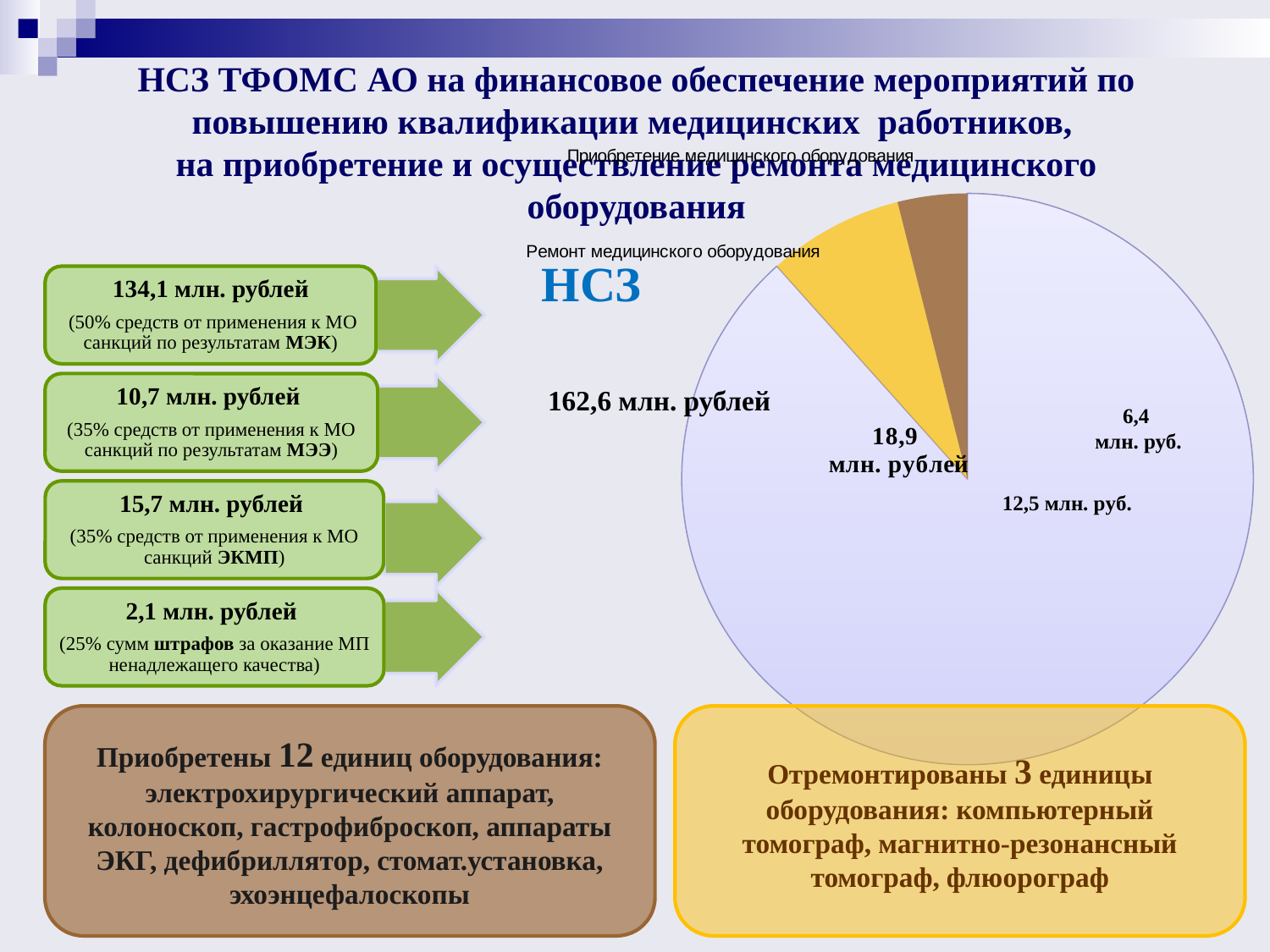
How many slices does the pie chart have? 3 What are the two category labels printed near the small slices of the pie chart? Приобретение медицинского оборудования; Ремонт медицинского оборудования Which slice of the pie chart is the smallest? the brown slice Is the yellow slice of the pie chart larger or smaller than the brown slice? larger Which slice of the pie chart is the largest? the light blue slice What total amount is printed next to the label НСЗ beside the pie chart? 162,6 млн. рублей What kind of chart is shown on the slide? pie chart